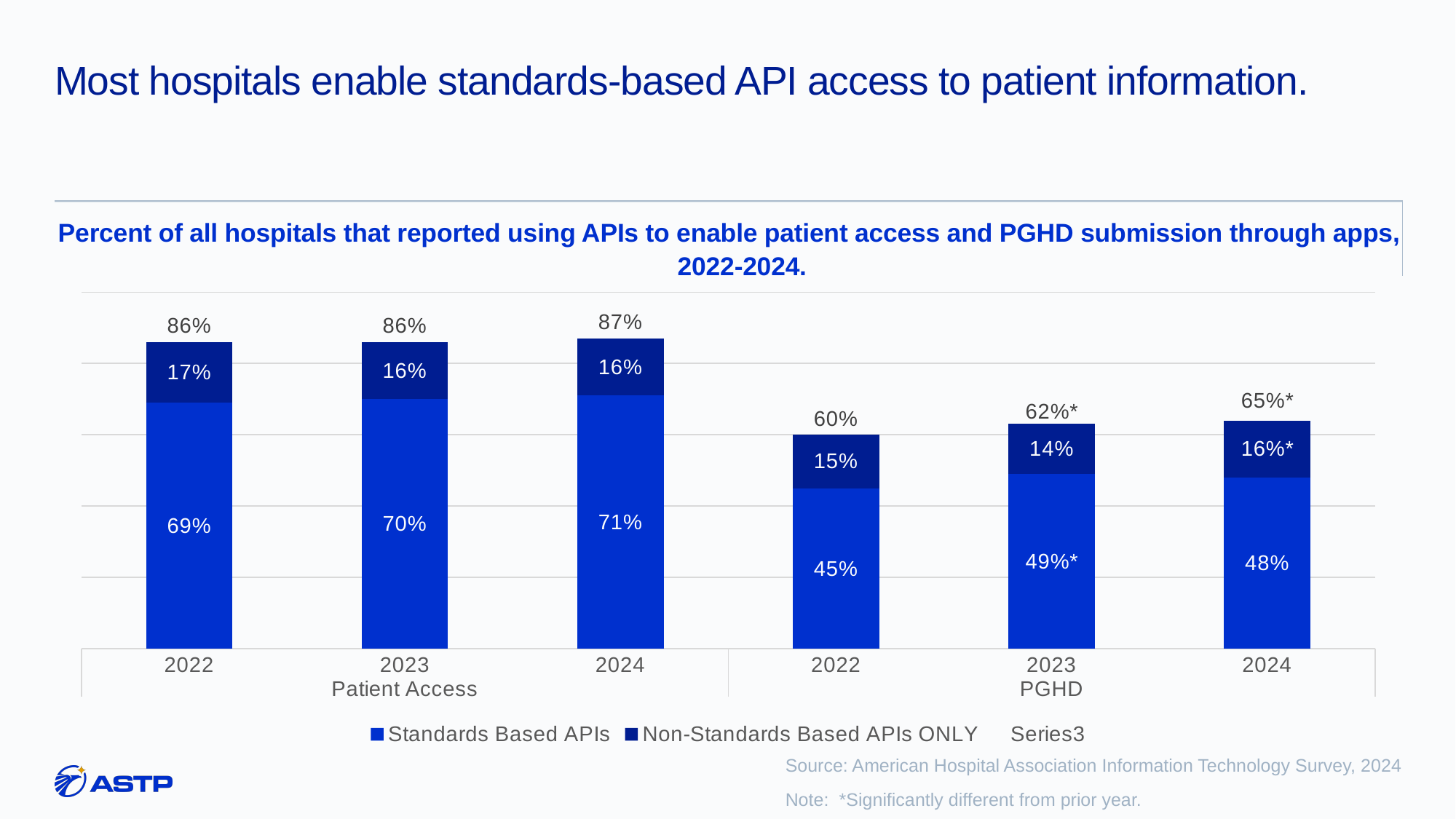
What is the Non-Standards Based APIs ONLY value for PGHD in 2022? 15% How many series does the legend list? 3 Which is larger: the Standards Based APIs value for PGHD in 2023 or in 2024? 2023 Which year has the lowest total for PGHD? 2022 Which year has the highest total for Patient Access? 2024 What is the total percent of hospitals using APIs for Patient Access in 2022? 86% What percent of hospitals reported using Standards Based APIs for Patient Access in 2024? 71% Do the PGHD totals rise or fall from 2022 to 2024? Rise What kind of chart is shown on the slide? Stacked bar chart How many bars are plotted in the chart? 6 What is the difference between the Standards Based APIs value for Patient Access in 2024 and for PGHD in 2024? 23 percentage points What is the total percent of hospitals using APIs for PGHD submission in 2024? 65%*